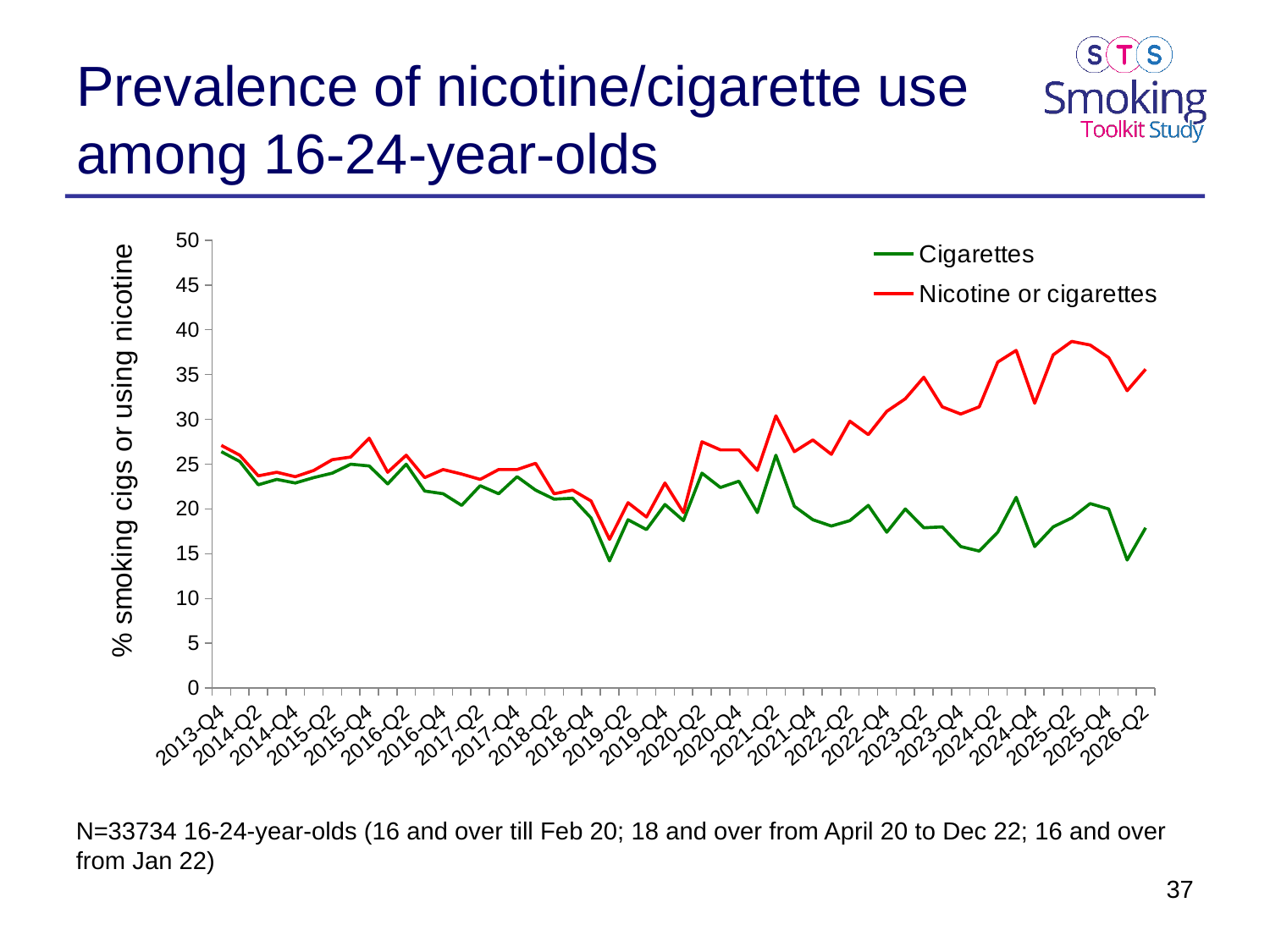
How many series does the legend list? 2 What is the label on the vertical axis? % smoking cigs or using nicotine Which series is drawn in red? Nicotine or cigarettes Does the Cigarettes line rise or fall overall between 2021-Q2 and 2023-Q4? fall Is the value for Cigarettes at 2026-Q2 greater or less than 20? less Is the value for Nicotine or cigarettes at 2013-Q4 greater or less than 25? greater Is the value for Nicotine or cigarettes at 2025-Q2 greater or less than 35? greater Does the Nicotine or cigarettes line rise or fall overall between 2021-Q4 and 2025-Q2? rise What kind of chart is shown on the slide? line chart At 2026-Q2, which series has the higher value, Cigarettes or Nicotine or cigarettes? Nicotine or cigarettes